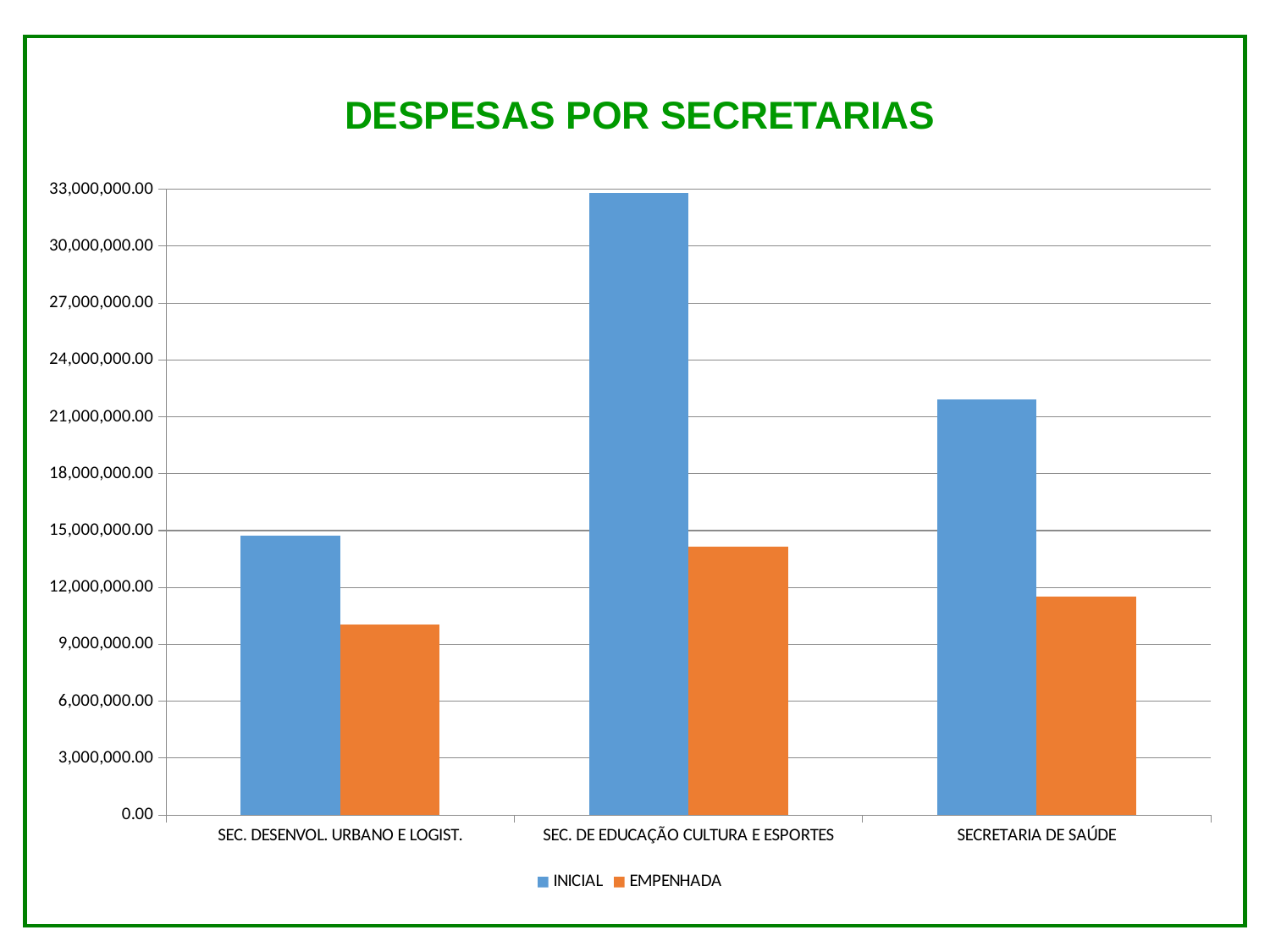
What kind of chart is shown on the slide? bar chart Is the EMPENHADA value for SEC. DESENVOL. URBANO E LOGIST. greater or less than 9,000,000.00? greater Which secretaria has the lowest INICIAL value? SEC. DESENVOL. URBANO E LOGIST. Which series is shown in orange in the legend? EMPENHADA Is the INICIAL value for SECRETARIA DE SAÚDE greater or less than 24,000,000.00? less Which secretaria has the lowest EMPENHADA value? SEC. DESENVOL. URBANO E LOGIST. What is the title of the chart? DESPESAS POR SECRETARIAS For SECRETARIA DE SAÚDE, which is larger, the INICIAL value or the EMPENHADA value? INICIAL How many series does the legend list? 2 How many secretarias (categories) are shown on the x axis? 3 Is the INICIAL value for SEC. DE EDUCAÇÃO CULTURA E ESPORTES greater or less than 30,000,000.00? greater Which secretaria has the highest INICIAL value? SEC. DE EDUCAÇÃO CULTURA E ESPORTES